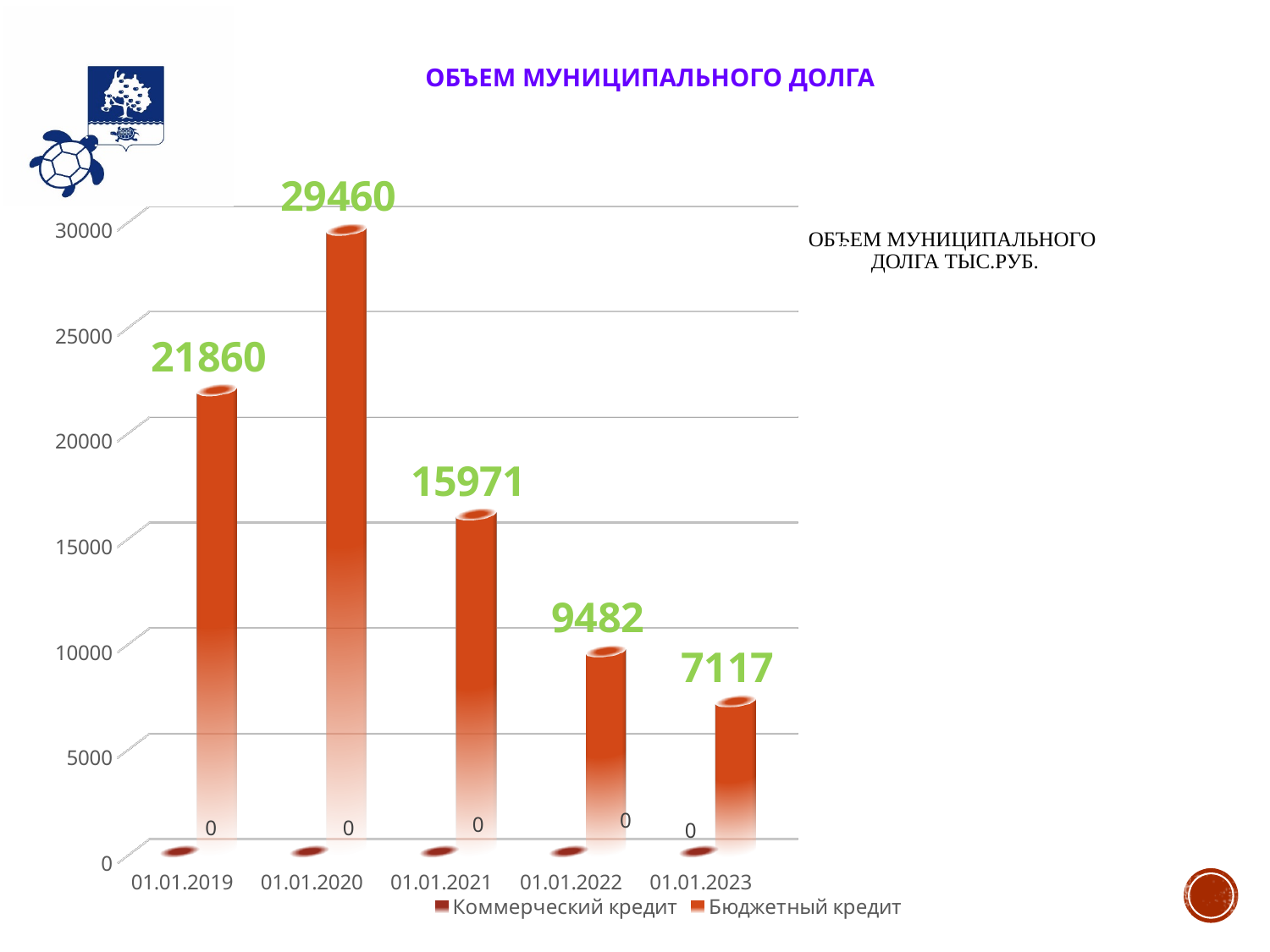
On which date is Бюджетный кредит highest? 01.01.2020 Which is larger, Бюджетный кредит on 01.01.2021 or on 01.01.2022? 01.01.2021 What kind of chart is shown on the slide? bar chart Does Бюджетный кредит rise or fall from 01.01.2020 to 01.01.2023? fall What is the difference between Бюджетный кредит on 01.01.2020 and on 01.01.2019? 7600 What is the value of Бюджетный кредит on 01.01.2023? 7117 How many dates are shown on the x axis? 5 How many series does the legend list? 2 On which date is Бюджетный кредит lowest? 01.01.2023 What is the value of Бюджетный кредит on 01.01.2020? 29460 What is the value of Коммерческий кредит on 01.01.2021? 0